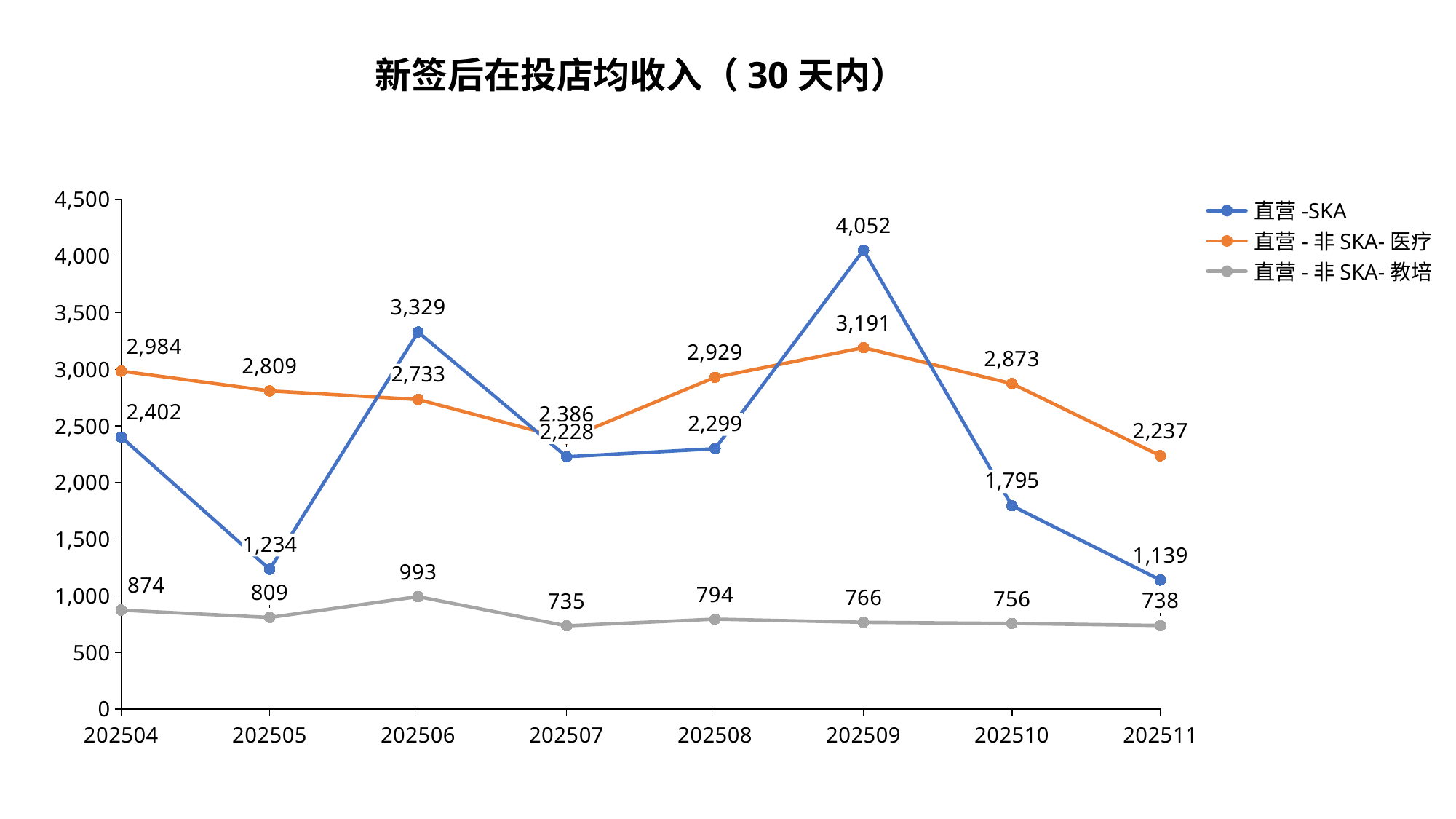
At which month does 直营-非SKA-教培 have its lowest value? 202507 At which month does 直营-SKA reach its highest value? 202509 What is the difference between 直营-SKA and 直营-非SKA-医疗 at 202511? 1,098 Is the value for 直营-SKA at 202506 greater or less than 3,000? greater How many series does the legend list? 3 Does 直营-非SKA-医疗 rise or fall from 202509 to 202511? fall Which is larger at 202505: 直营-SKA or 直营-非SKA-医疗? 直营-非SKA-医疗 How many months are shown on the x axis? 8 What kind of chart is this? line chart What is the value for 直营-SKA at 202509? 4,052 What is the value for 直营-非SKA-教培 at 202506? 993 What is the value for 直营-非SKA-医疗 at 202504? 2,984